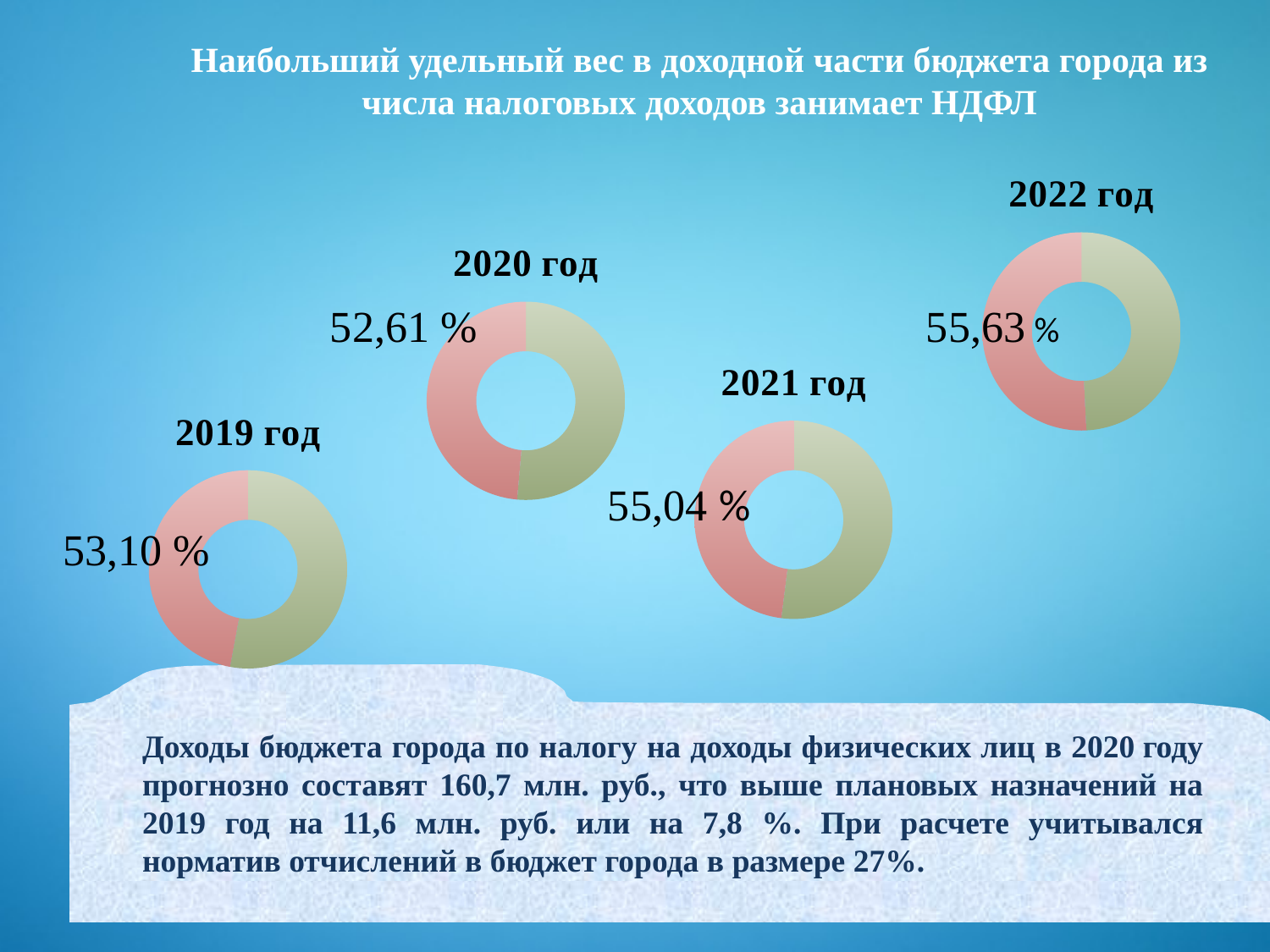
Which is larger, the value for 2019 год or the value for 2020 год? 2019 год What value is shown for the 2020 год donut chart? 52,61 % How many donut charts are shown on the slide? 4 What is the difference between the value for 2022 год and the value for 2019 год? 2,53 % Which year's donut chart shows the lowest value? 2020 год What value is shown for the 2019 год donut chart? 53,10 % What value is shown for the 2022 год donut chart? 55,63 % What is the difference between the value for 2021 год and the value for 2020 год? 2,43 % Which year's donut chart shows the highest value? 2022 год Do the values rise or fall from 2020 год to 2022 год? Rise What value is shown for the 2021 год donut chart? 55,04 % What kind of chart is used for each year on the slide? Donut (pie) chart